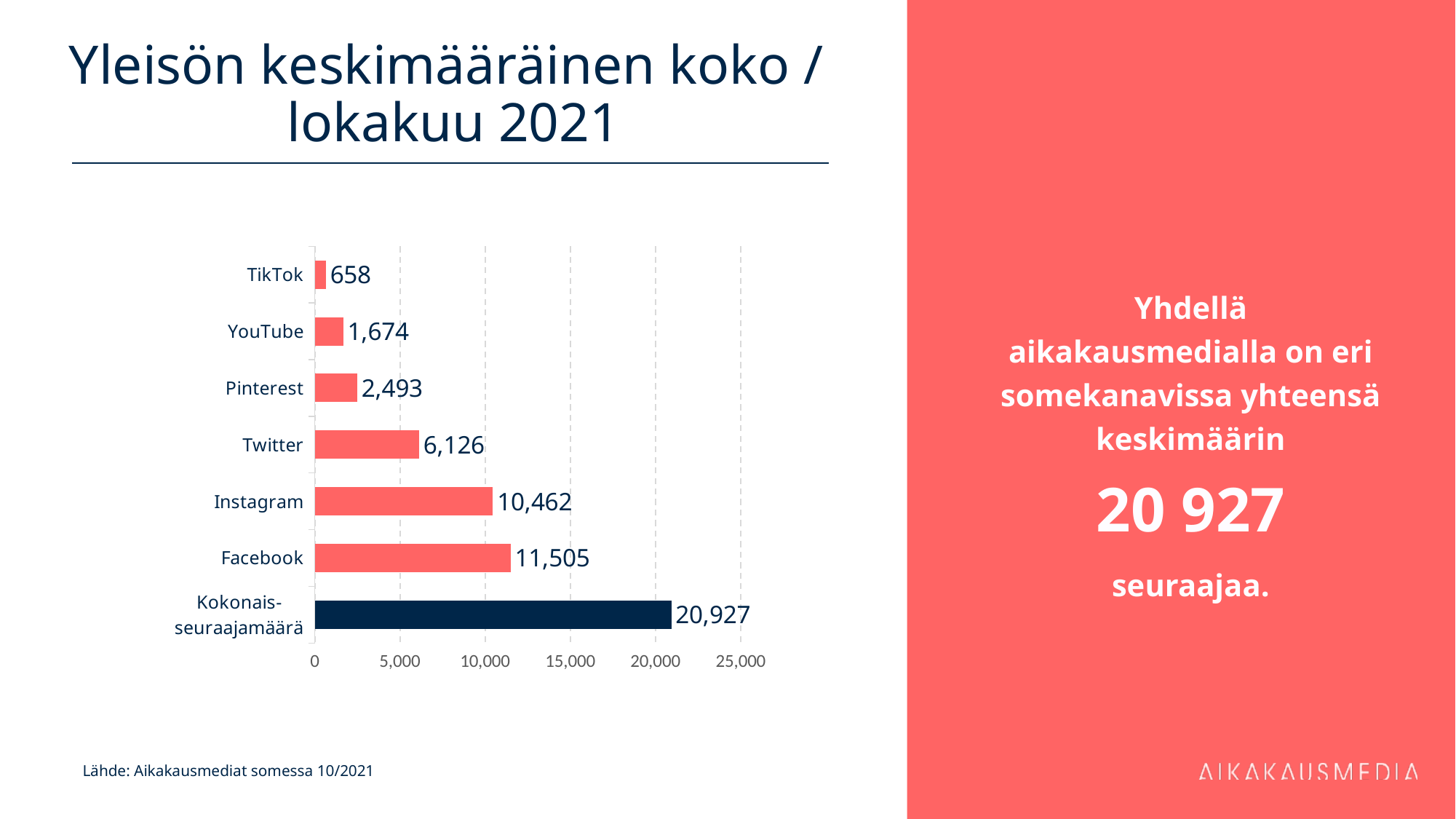
What is the value for TikTok? 658 What kind of chart is shown on the slide? bar chart What is the value for Facebook? 11,505 What is the difference between the values for Facebook and Instagram? 1,043 How many categories are shown in the chart? 7 What is the title of the slide containing the chart? Yleisön keskimääräinen koko / lokakuu 2021 What is the value for Kokonais-seuraajamäärä? 20,927 Which individual social media channel has the highest value? Facebook Is the value for Instagram greater or less than 10,000? greater Which is larger, the value for YouTube or the value for Pinterest? Pinterest What is the difference between the values for Twitter and Pinterest? 3,633 Which category has the lowest value? TikTok